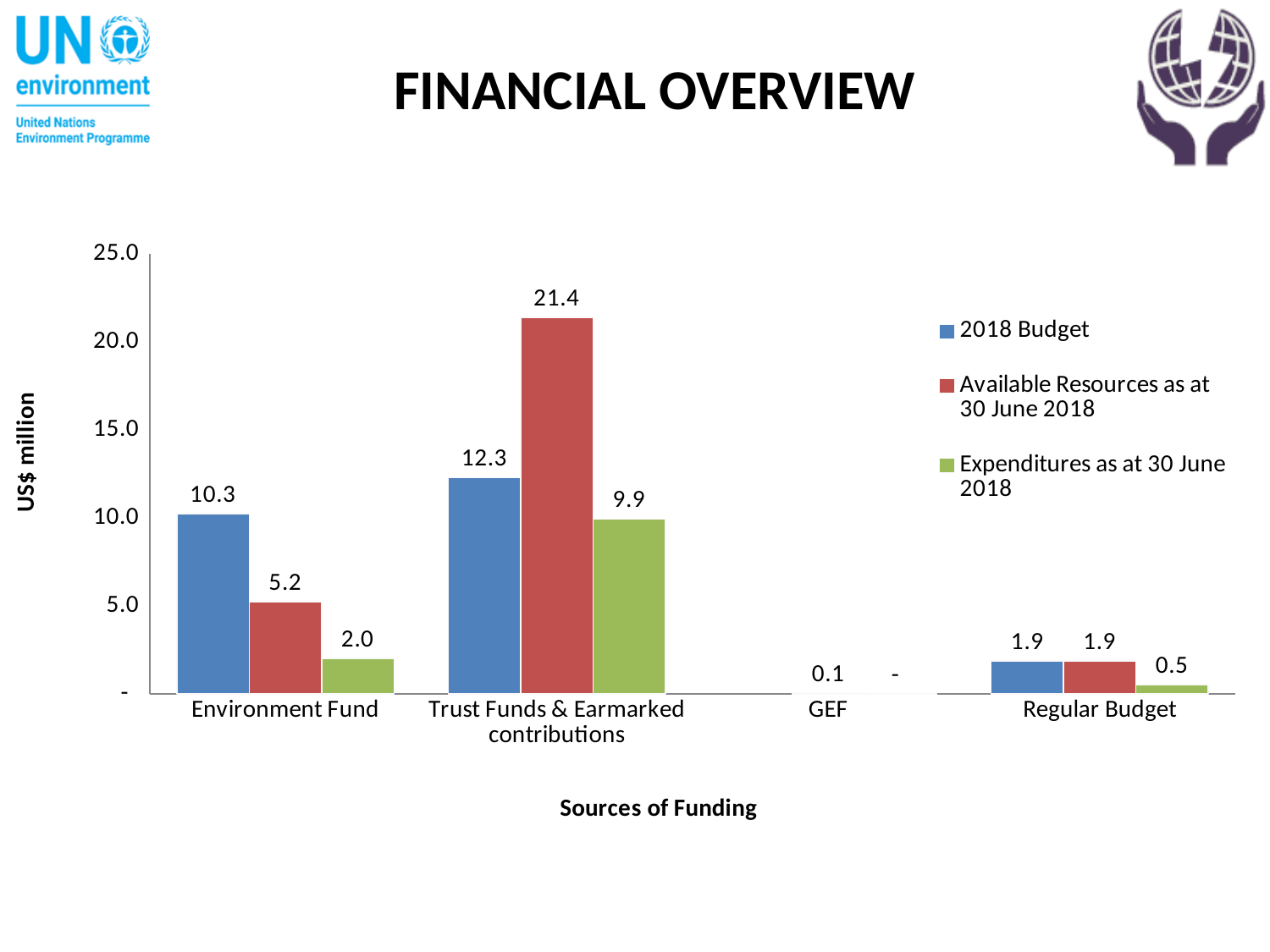
What is the Expenditures as at 30 June 2018 value for Regular Budget? 0.5 What is the Available Resources as at 30 June 2018 value for Trust Funds & Earmarked contributions? 21.4 Which source of funding has the lowest 2018 Budget? Regular Budget Which source of funding has the highest Available Resources as at 30 June 2018? Trust Funds & Earmarked contributions What is the 2018 Budget value for Environment Fund? 10.3 What kind of chart is shown on the slide? Bar chart Which is larger for Trust Funds & Earmarked contributions: the 2018 Budget or the Available Resources as at 30 June 2018? Available Resources as at 30 June 2018 What is the label of the y axis? US$ million How many series does the legend list? 3 Is the Expenditures as at 30 June 2018 value for Trust Funds & Earmarked contributions greater or less than 5.0? greater How many sources of funding are shown on the x axis? 4 What is the difference between the 2018 Budget and the Expenditures as at 30 June 2018 for Environment Fund? 8.3